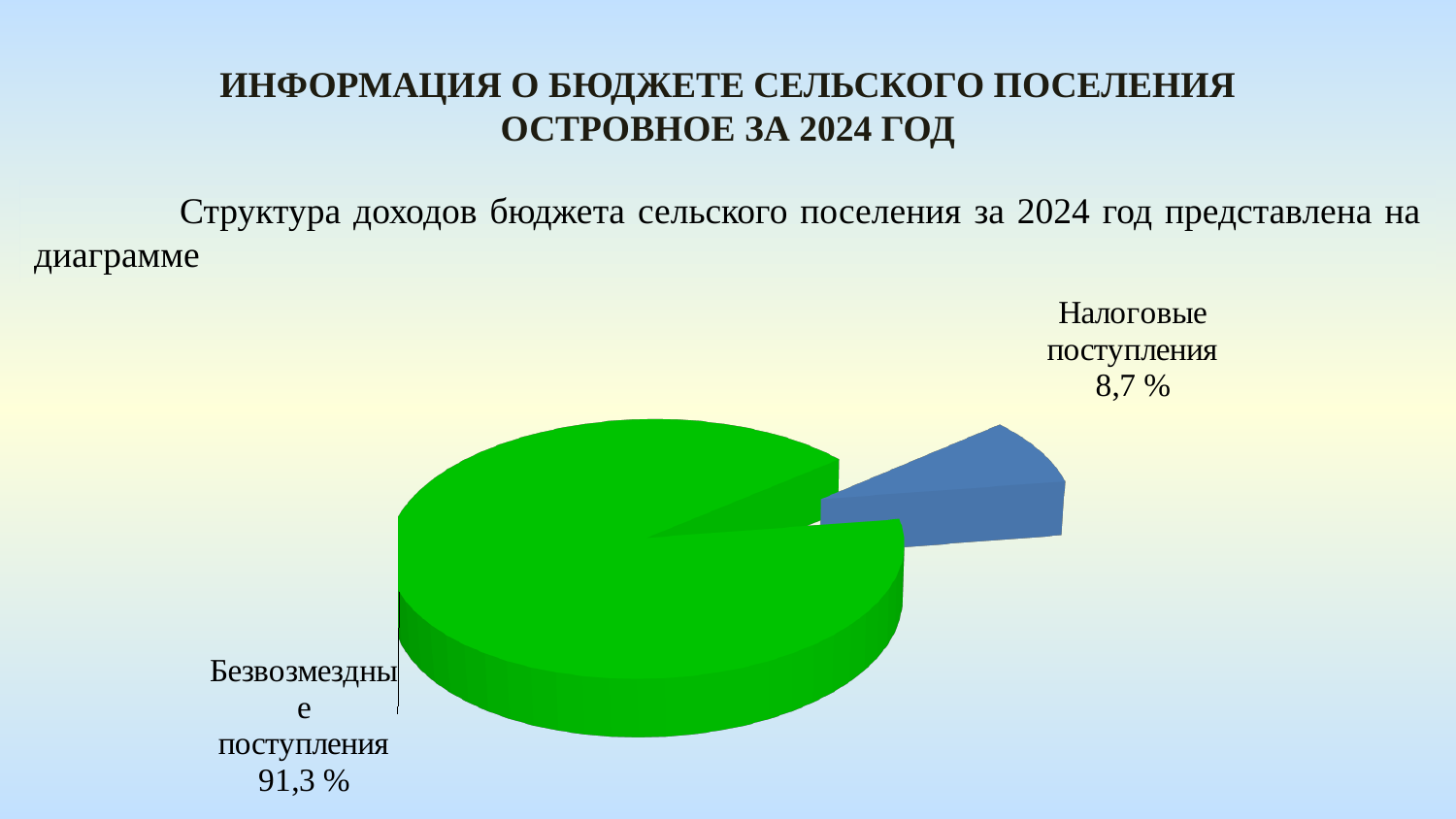
What is the difference in percentage points between Безвозмездные поступления and Налоговые поступления? 82,6 What colour is the slice for Налоговые поступления? Blue Which is larger: Безвозмездные поступления or Налоговые поступления? Безвозмездные поступления What kind of chart is shown on the slide? Pie chart What share of the pie is labelled for Безвозмездные поступления? 91,3 % Is the share for Безвозмездные поступления greater or less than 50%? greater What share of the pie is labelled for Налоговые поступления? 8,7 % What colour is the slice for Безвозмездные поступления? Green Which slice of the pie is the largest? Безвозмездные поступления Which slice of the pie is the smallest? Налоговые поступления How many slices does the pie chart have? 2 Is the share for Налоговые поступления greater or less than 10%? less